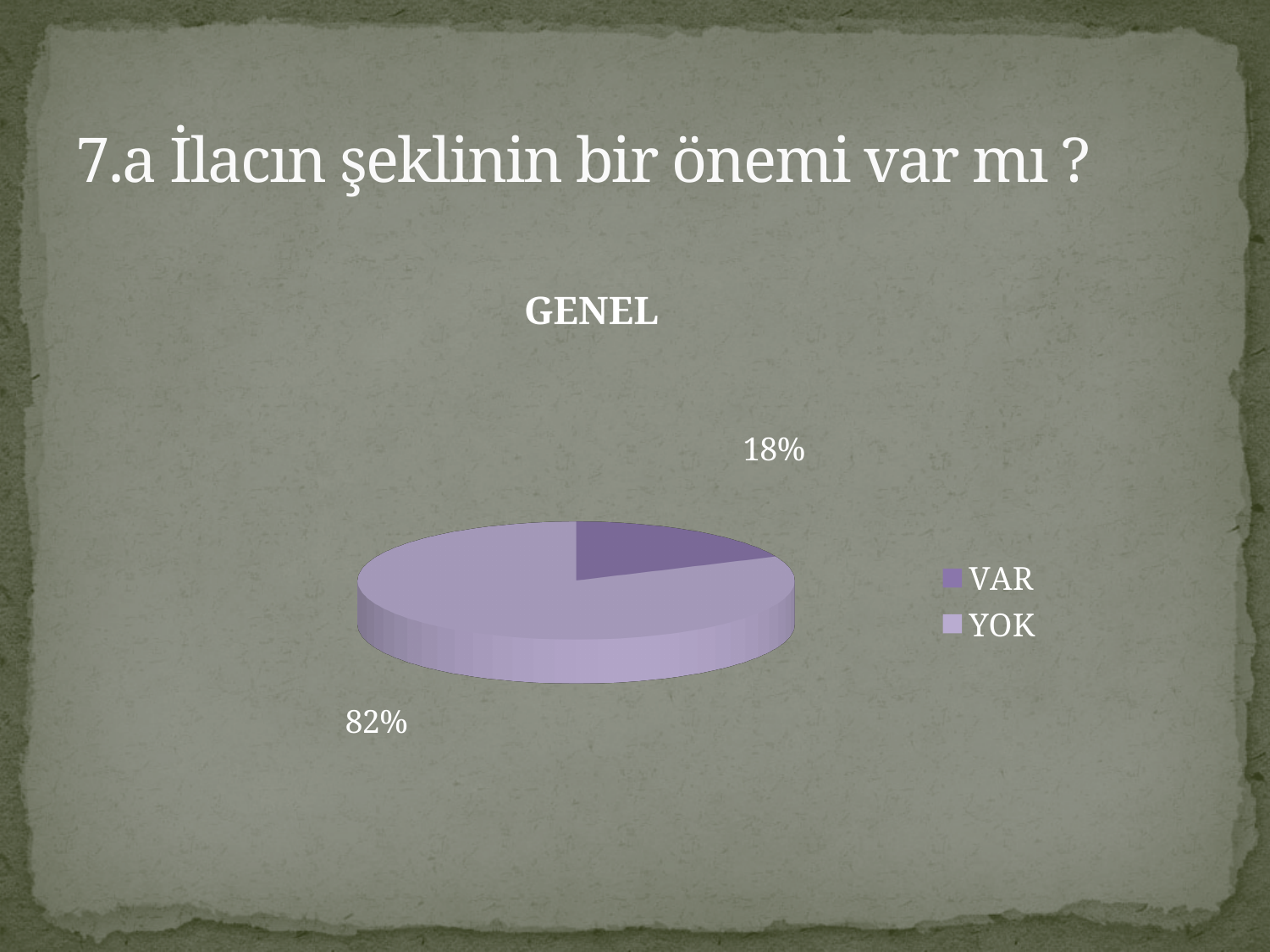
What is the title of the chart? GENEL Which legend entry is shown in the darker purple colour? VAR What percentage does the YOK slice represent? 82% How many slices does the pie chart have? 2 Which is larger, the VAR slice or the YOK slice? YOK What kind of chart is shown on the slide? pie chart Which category has the largest share of the pie? YOK What is the difference in percentage points between the YOK and VAR slices? 64 What percentage does the VAR slice represent? 18% What share of the pie does the YOK slice take? 82% Which category has the smallest share of the pie? VAR How many entries does the legend list? 2